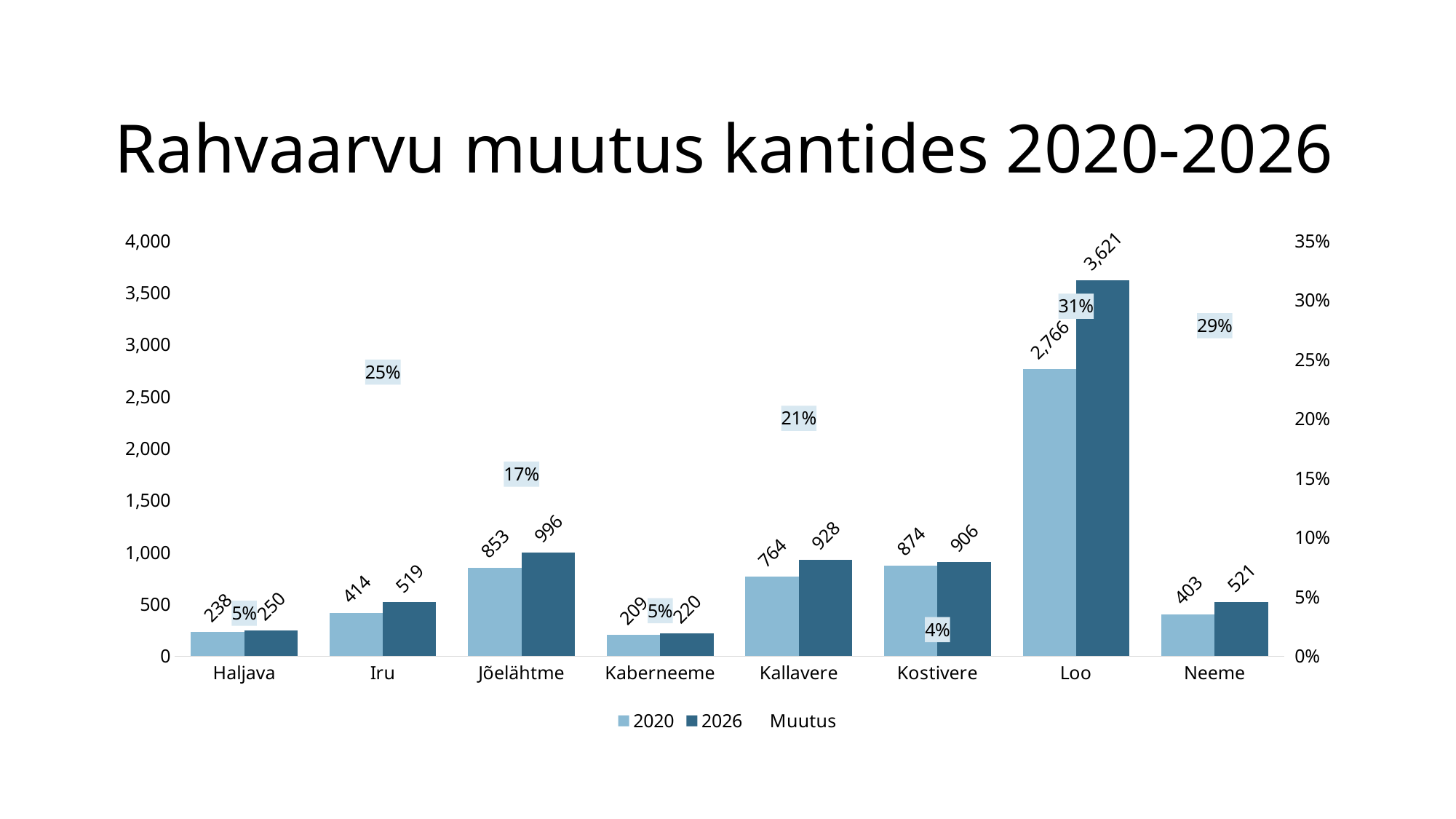
What is the Muutus percentage shown for Neeme? 29% How many series does the legend list? 3 How many categories are shown on the x axis? 8 What is the 2020 value for Loo? 2,766 What is the difference between the 2026 and 2020 values for Iru? 105 Is the 2026 value for Loo greater or less than 3,500? greater What kind of chart is shown on the slide? bar chart What is the 2026 value for Jõelähtme? 996 Which category has the highest 2026 value? Loo Which category has the lowest 2020 value? Kaberneeme What is the title of the chart? Rahvaarvu muutus kantides 2020-2026 Which is larger, the 2026 value for Kallavere or the 2026 value for Kostivere? Kallavere